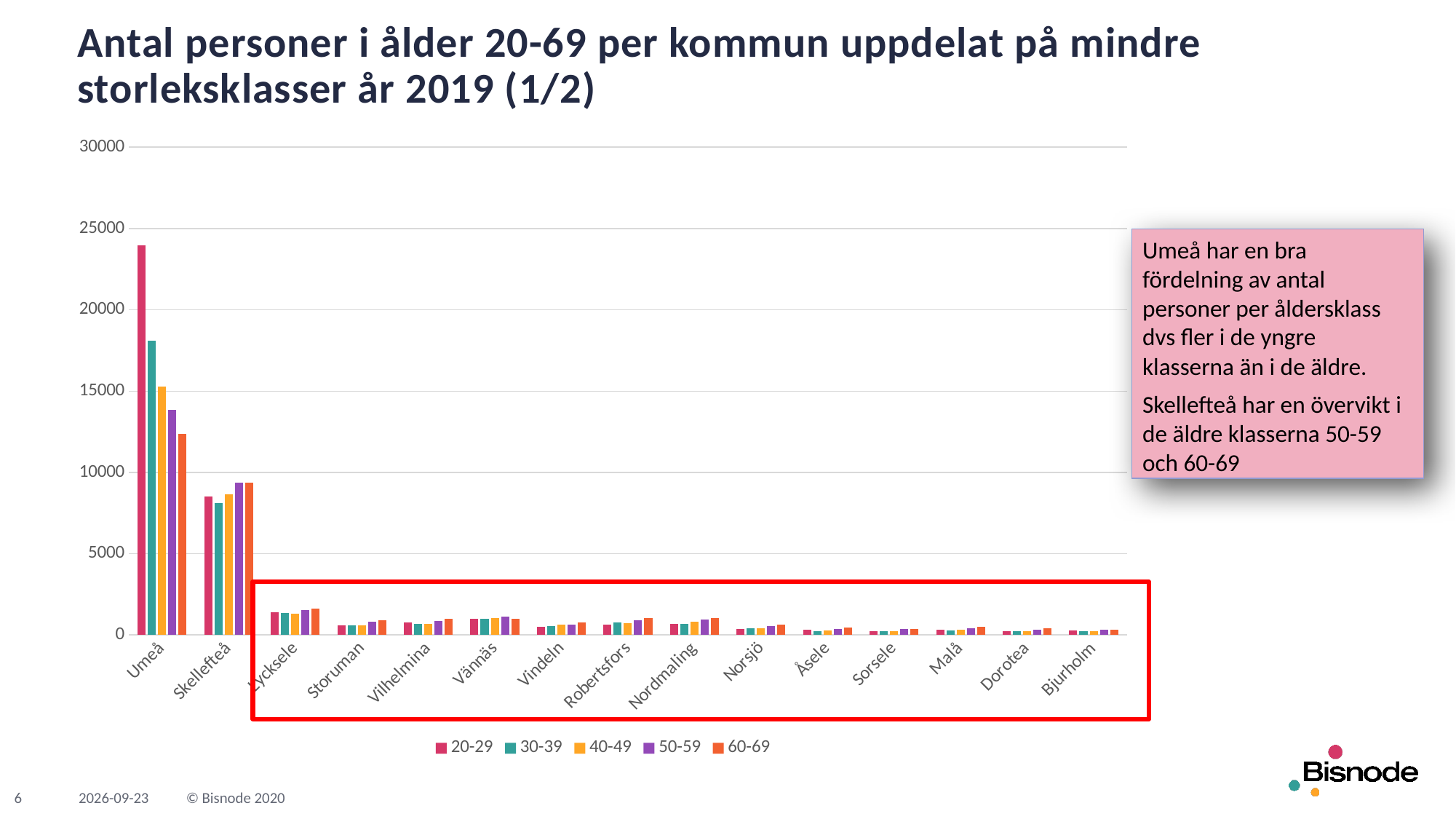
Which is larger: the 20-29 value for Umeå or the 20-29 value for Skellefteå? Umeå How many series does the legend list? 5 For Skellefteå, which is larger: the 30-39 value or the 60-69 value? 60-69 Is the value for Umeå in the 60-69 group greater or less than 10000? greater Within Umeå, which age group has the lowest bar? 60-69 Which municipality has the tallest bar in the chart? Umeå How many municipalities are shown on the x axis? 15 Is the value for Umeå in the 20-29 group greater or less than 20000? greater Is the value for Skellefteå in the 20-29 group greater or less than 10000? less What kind of chart is shown on the slide? Bar chart